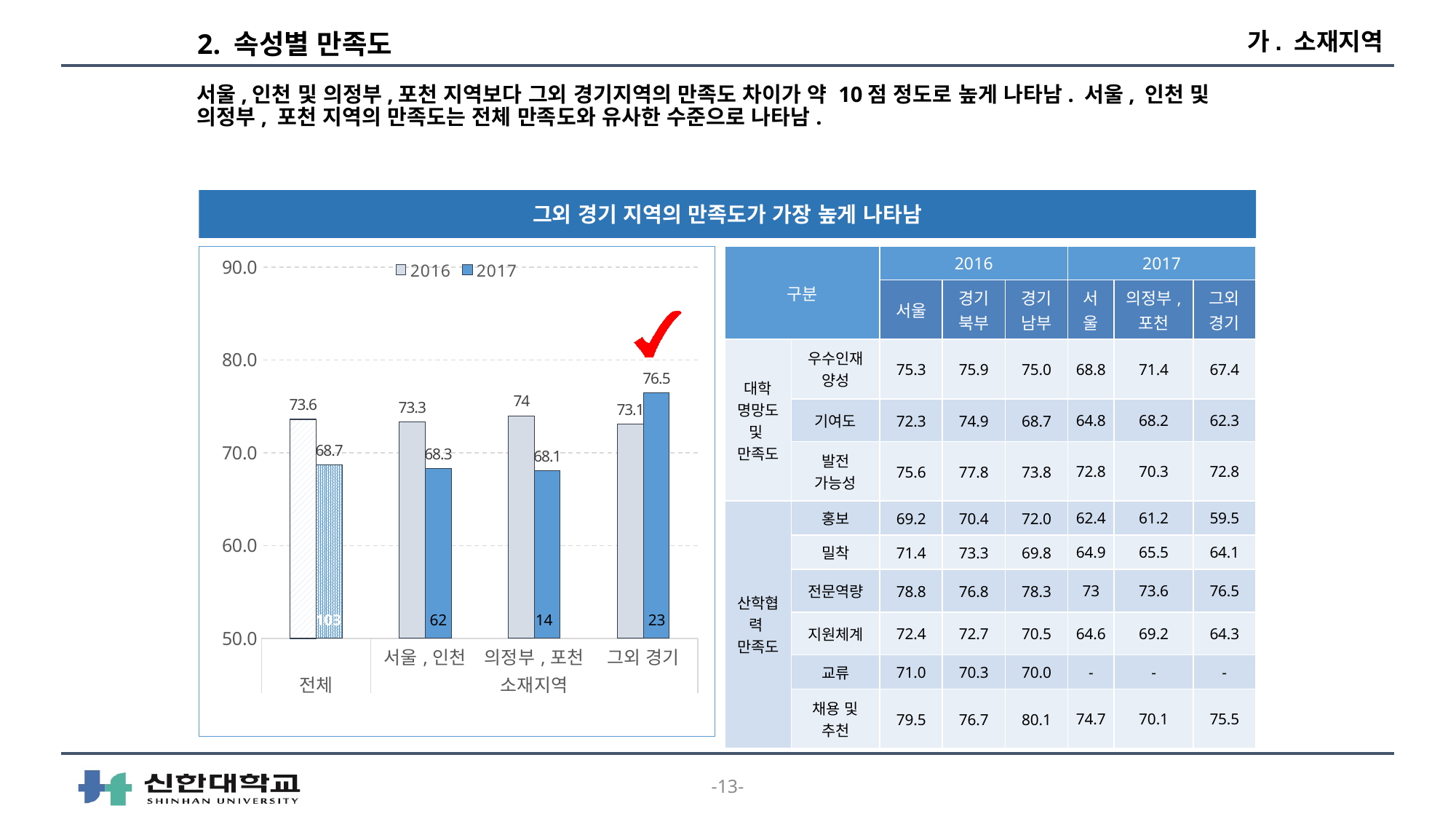
What kind of chart is shown on the slide? bar chart Which category has the highest 2017 value in the bar chart? 그외 경기 What is the difference between the 2017 and 2016 values for 그외 경기 in the bar chart? 3.4 What is the 2017 value for 그외 경기 in the bar chart? 76.5 Which is larger for 서울, 인천 in the bar chart: the 2016 value or the 2017 value? 2016 What is the title shown in the blue banner above the chart? 그외 경기 지역의 만족도가 가장 높게 나타남 What is the 2016 value for 전체 in the bar chart? 73.6 Which category has the lowest 2017 value in the bar chart? 의정부, 포천 What is the 2017 value for 의정부, 포천 in the bar chart? 68.1 What is the 2016 value for 서울, 인천 in the bar chart? 73.3 How many categories are shown on the x axis of the bar chart? 4 How many series does the legend of the bar chart list? 2